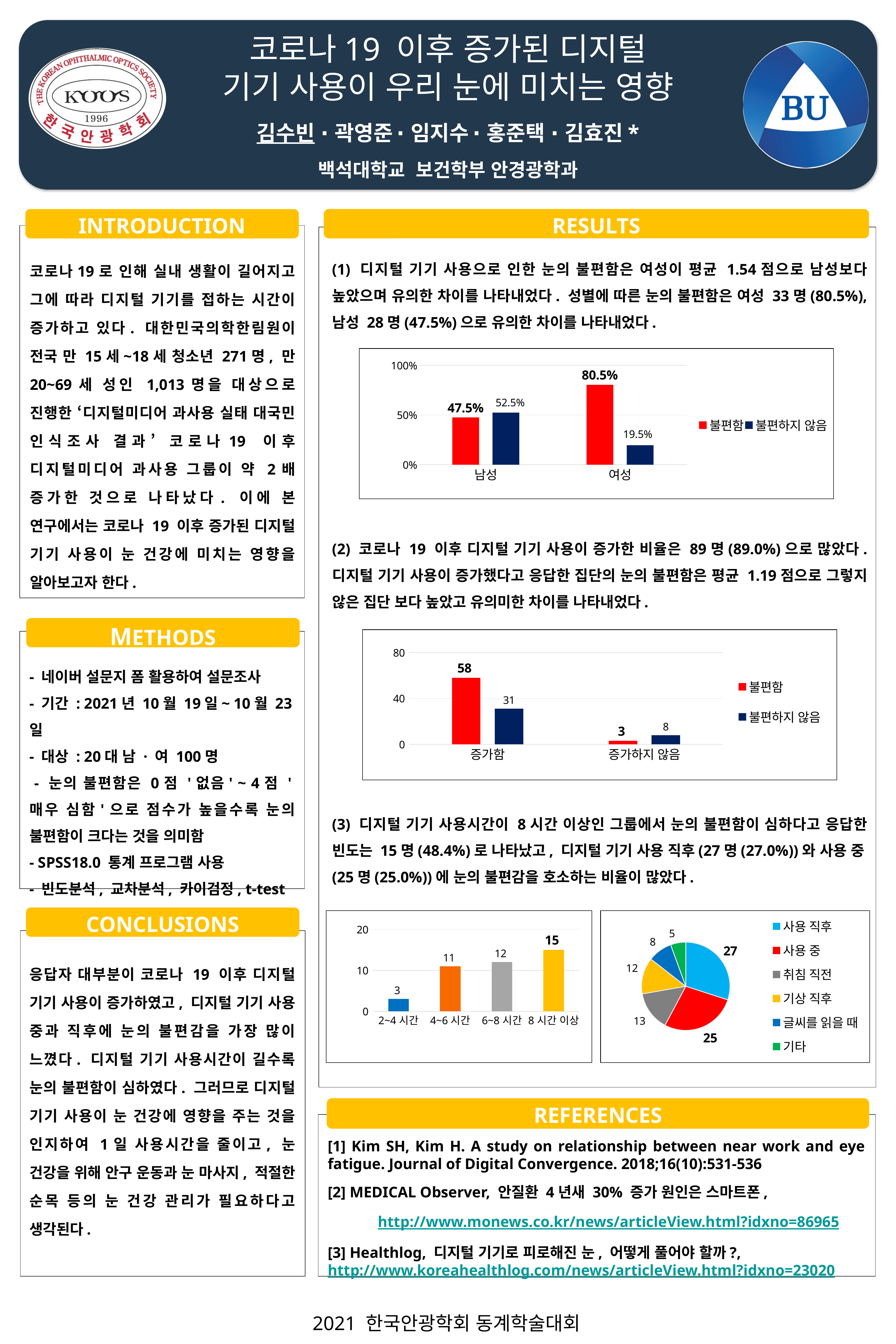
In the top bar chart (by gender), what is the value for 불편하지 않음 for 남성? 52.5% What kind of chart is the bottom-right chart? pie chart In the middle bar chart (증가함 / 증가하지 않음), what is the difference between 불편함 and 불편하지 않음 in the 증가함 group? 27 In the middle bar chart (증가함 / 증가하지 않음), what is the value for 불편함 in the 증가함 group? 58 In the bottom-left bar chart (usage hours), which category has the highest value? 8 시간 이상 In the middle bar chart (증가함 / 증가하지 않음), which of 불편함 or 불편하지 않음 is larger in the 증가하지 않음 group? 불편하지 않음 In the top bar chart (by gender), what is the value for 불편함 for 여성? 80.5% In the bottom-left bar chart (usage hours), do the values rise or fall from left to right along the x axis? rise In the bottom-left bar chart (usage hours), what is the value for 4~6 시간? 11 In the top bar chart (by gender), how many series does the legend list? 2 In the bottom-right pie chart, which slice is the smallest? 기타 In the top bar chart (by gender), what is the difference between 불편함 for 여성 and 불편함 for 남성? 33.0%